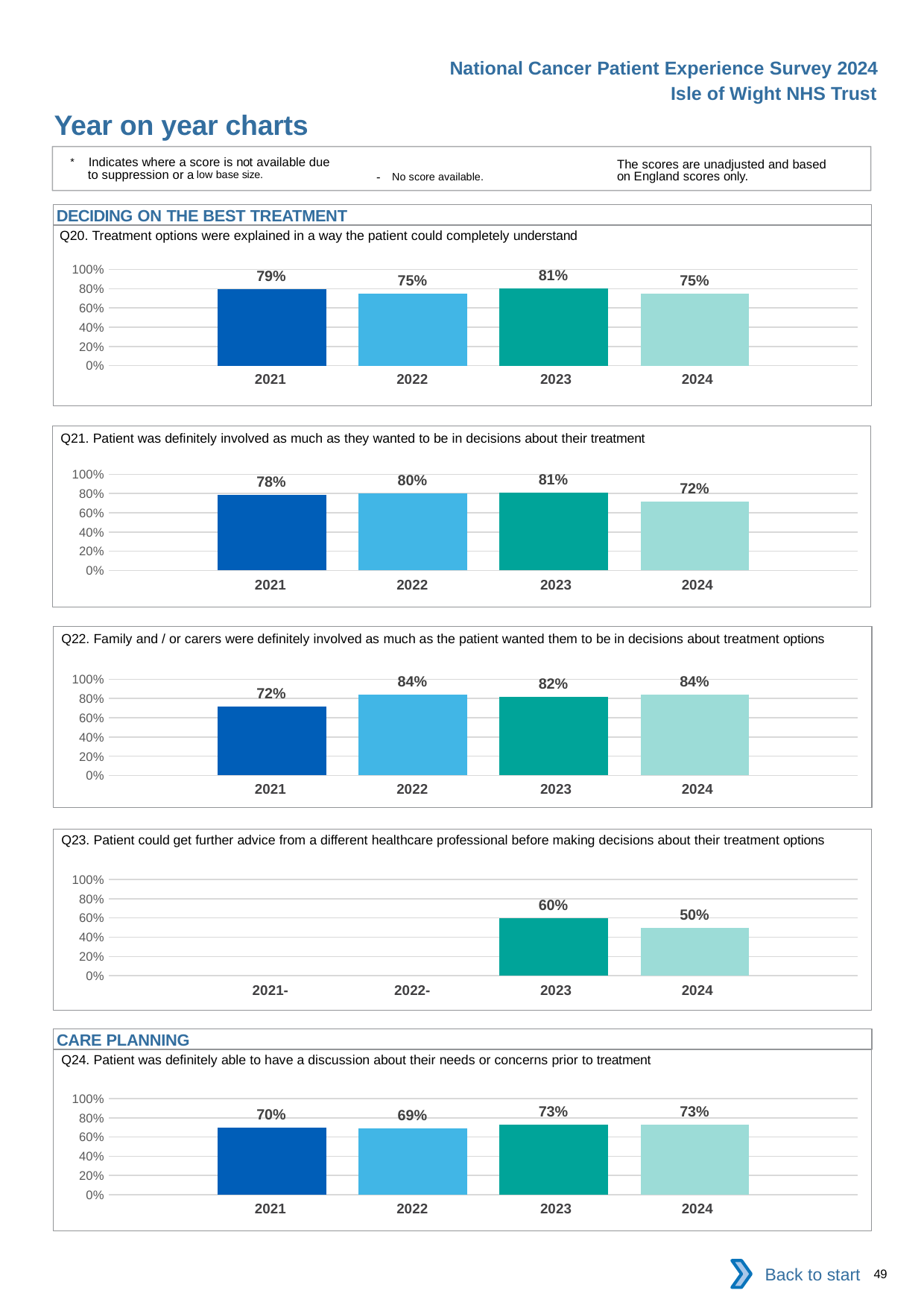
In the Q21 chart, what is the value for 2024? 72% In the Q24 chart, what is the difference between the 2021 and 2023 values? 3 percentage points In the Q24 chart, what is the value for 2022? 69% In the Q21 chart, what is the difference between the 2023 and 2024 values? 9 percentage points In the Q20 chart, which year has the lowest value? 2022 and 2024 What kind of chart is the Q21 chart? bar chart In the Q22 chart, is the value for 2021 larger or smaller than the value for 2022? smaller In the Q23 chart, how many years have a bar plotted? 2 In the Q20 chart, what is the value for 2023? 81% How many charts are shown on the slide? 5 In the Q22 chart, which year has the lowest value? 2021 In the Q23 chart, what is the value for 2023? 60%